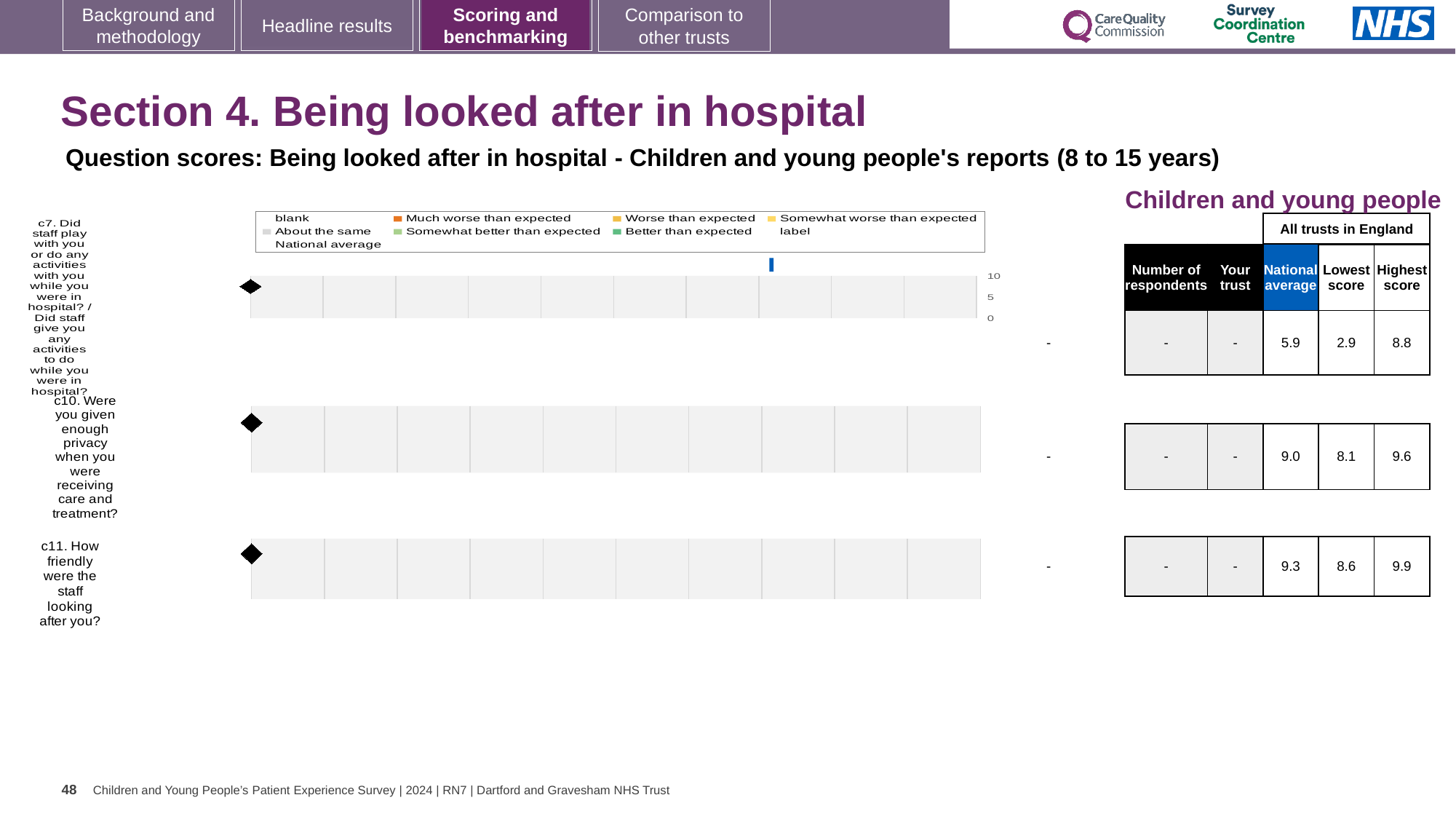
What is the highest score across all trusts in England for c10 (Were you given enough privacy when you were receiving care and treatment?)? 9.6 What is the title of the table to the right of the chart? Children and young people Which of the three questions has the highest national average score? c11. How friendly were the staff looking after you? Which of the three questions has the lowest national average score? c7. Did staff play with you or do any activities with you while you were in hospital? What is the lowest score across all trusts in England for c7 (Did staff play with you or do any activities with you while you were in hospital?)? 2.9 What is shown as the trust's own score (Your trust) for c10? - How many survey questions (categories) are listed down the left of the chart? 3 What is the maximum value shown on the chart's score axis? 10 What kind of chart is shown on the slide? bar chart What is the difference between the highest score and the lowest score for c7? 5.9 What is the national average score for c11 (How friendly were the staff looking after you?)? 9.3 Which has the larger national average: c10 or c11? c11